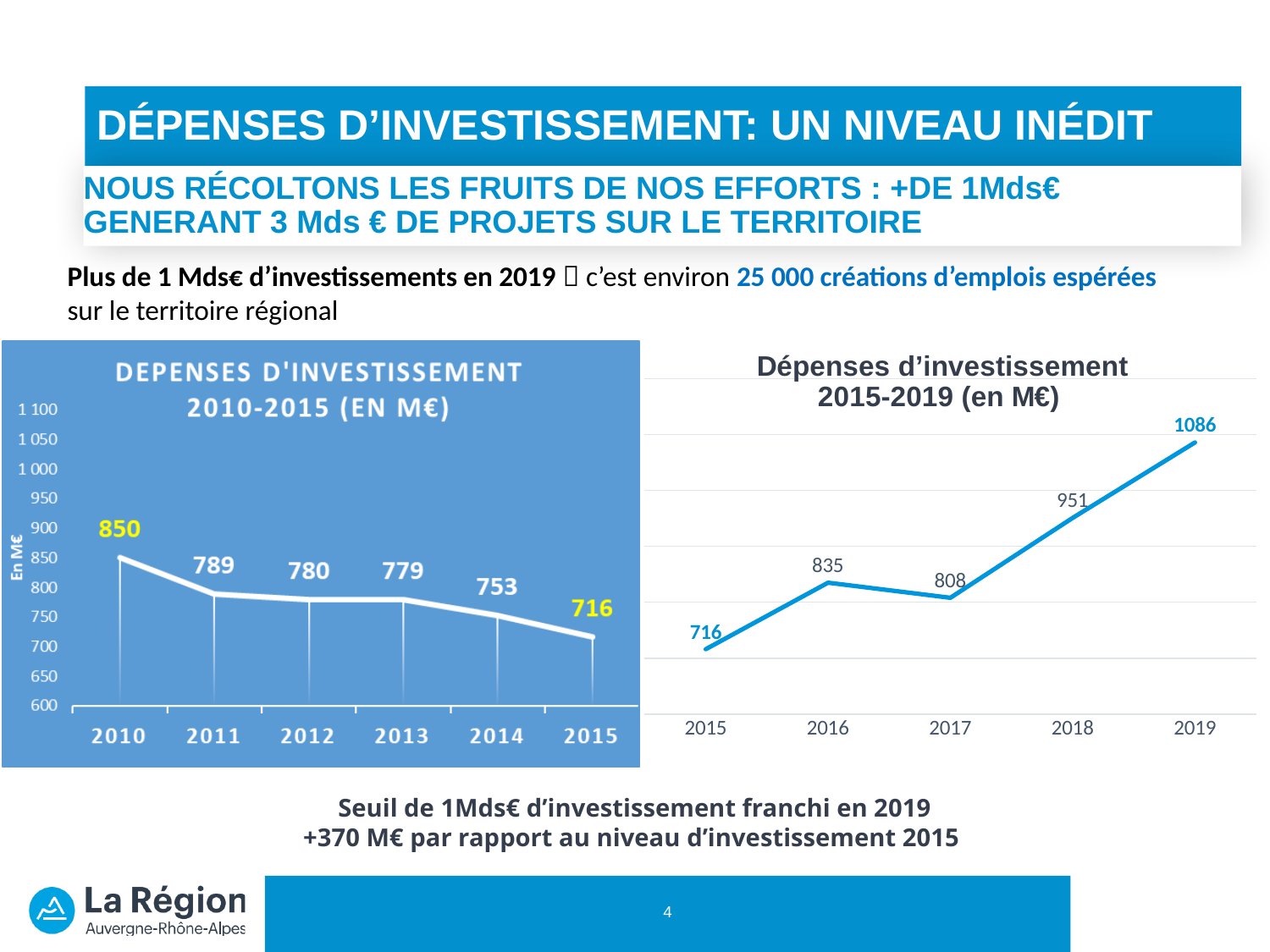
What kind of chart is the chart titled 'Dépenses d'investissement 2015-2019 (en M€)'? line chart In the chart titled 'DEPENSES D'INVESTISSEMENT 2010-2015 (EN M€)', what is the value for 2010? 850 In the chart titled 'Dépenses d'investissement 2015-2019 (en M€)', which is larger, the value for 2016 or the value for 2017? 2016 In the chart titled 'DEPENSES D'INVESTISSEMENT 2010-2015 (EN M€)', what is the value for 2014? 753 In the chart titled 'DEPENSES D'INVESTISSEMENT 2010-2015 (EN M€)', do the values rise or fall from 2010 to 2015? fall In the chart titled 'Dépenses d'investissement 2015-2019 (en M€)', which year has the highest value? 2019 In the chart titled 'DEPENSES D'INVESTISSEMENT 2010-2015 (EN M€)', which year has the lowest value? 2015 In the chart titled 'Dépenses d'investissement 2015-2019 (en M€)', what is the value for 2018? 951 In the chart titled 'DEPENSES D'INVESTISSEMENT 2010-2015 (EN M€)', what is the difference between the 2010 and 2015 values? 134 In the chart titled 'Dépenses d'investissement 2015-2019 (en M€)', how many data points are plotted? 5 In the chart titled 'Dépenses d'investissement 2015-2019 (en M€)', what is the difference between the 2019 and 2015 values? 370 In the chart titled 'DEPENSES D'INVESTISSEMENT 2010-2015 (EN M€)', how many years are plotted? 6